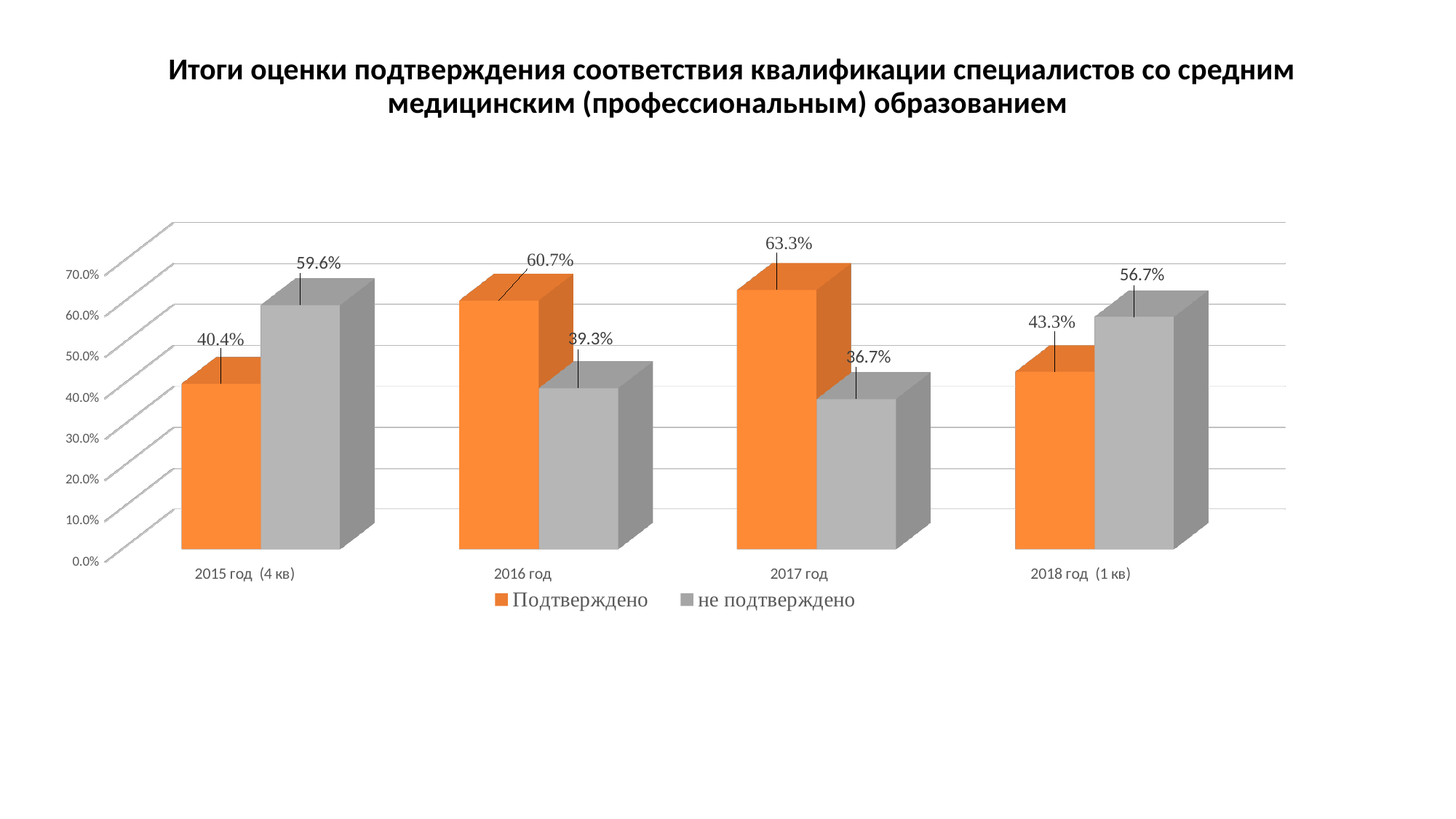
Which colour represents the Подтверждено series? orange How many categories are shown on the x axis? 4 How many series does the legend list? 2 What is the value for Подтверждено in 2016 год? 60.7% Is the Подтверждено value for 2015 год (4 кв) greater or less than 50.0%? less Which is larger in 2018 год (1 кв): Подтверждено or не подтверждено? не подтверждено What is the value for не подтверждено in 2015 год (4 кв)? 59.6% What is the difference between the Подтверждено and не подтверждено values in 2017 год? 26.6% What kind of chart is shown on the slide? bar chart What is the value for не подтверждено in 2018 год (1 кв)? 56.7% In which category is the Подтверждено value highest? 2017 год In which category is the не подтверждено value lowest? 2017 год